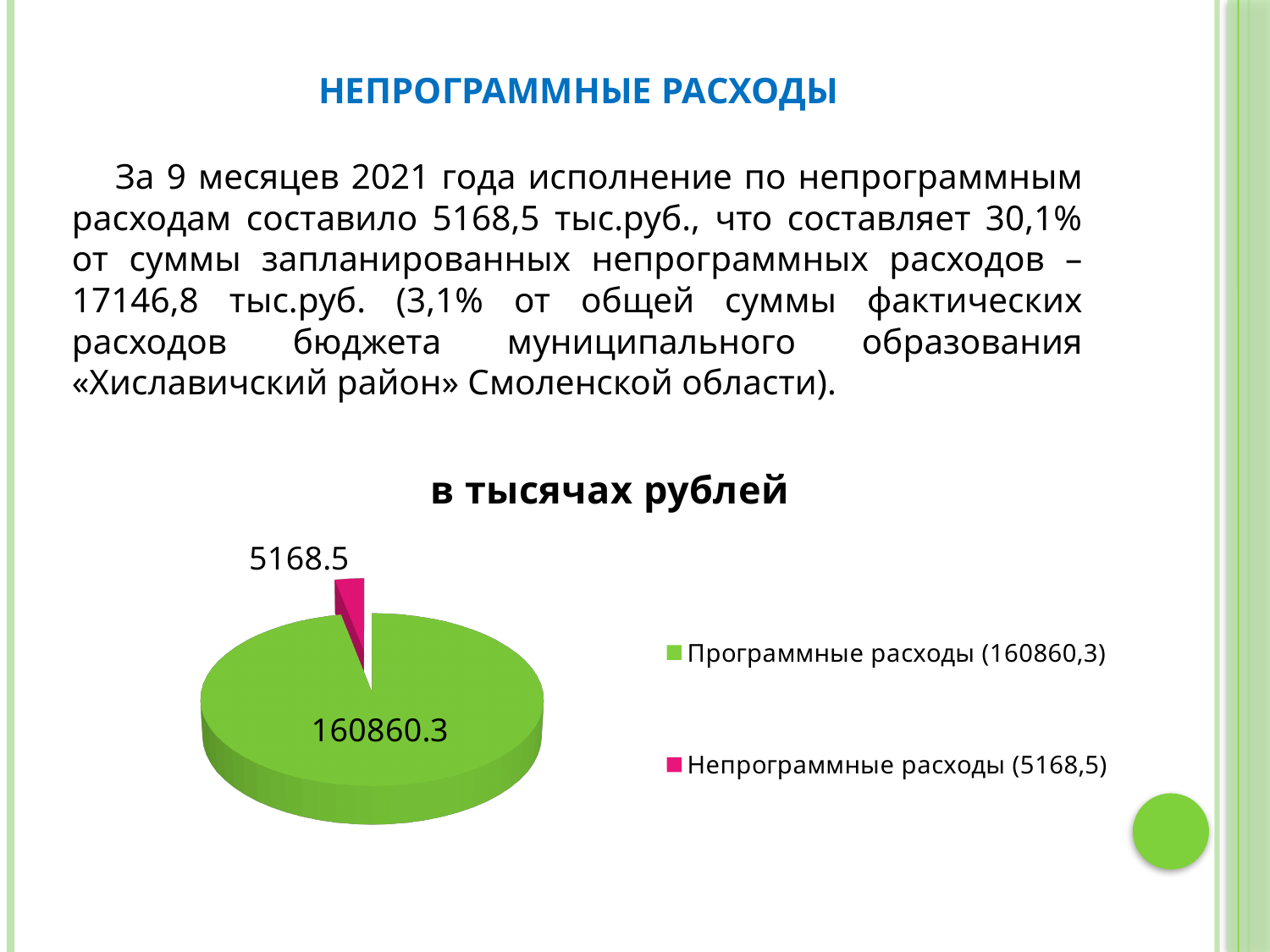
What kind of chart is shown on the slide? pie chart How many entries does the legend list? 2 What is the total of the two slices in the pie chart? 166028.8 What is the value for Непрограммные расходы in the pie chart? 5168.5 How many slices does the pie chart have? 2 What is the value for Программные расходы in the pie chart? 160860.3 Which is larger, Программные расходы or Непрограммные расходы? Программные расходы What is the difference between Программные расходы and Непрограммные расходы? 155691.8 What is the title of the pie chart? в тысячах рублей Which category has the largest slice in the pie chart? Программные расходы What share of the pie does Непрограммные расходы represent? 3.1% Which category has the smallest slice in the pie chart? Непрограммные расходы